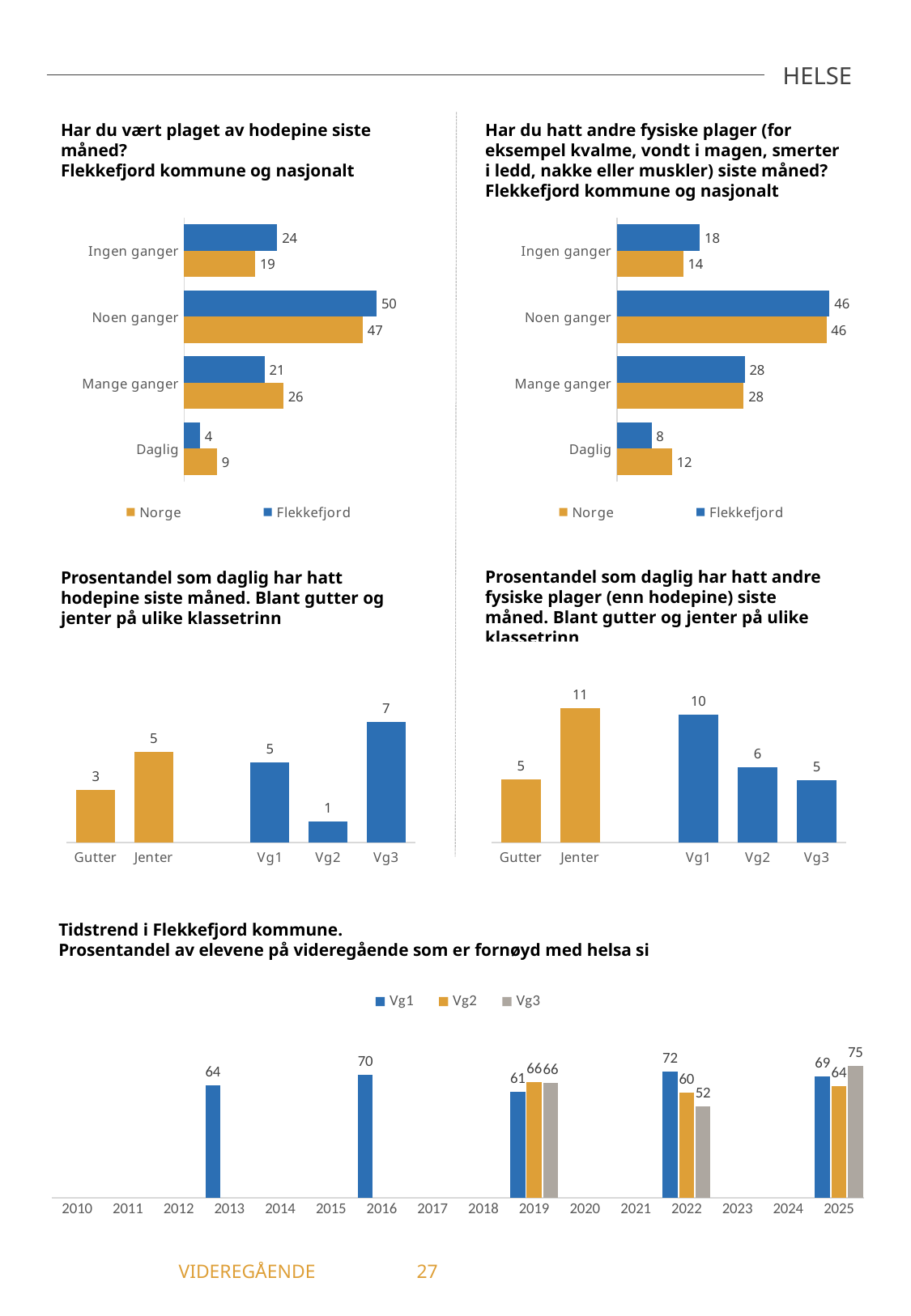
In the chart 'Prosentandel som daglig har hatt andre fysiske plager (enn hodepine) siste måned', which is larger, the value for Gutter or for Jenter? Jenter In the chart 'Tidstrend i Flekkefjord kommune', what is the value for Vg3 in 2025? 75 In the chart 'Har du vært plaget av hodepine siste måned?', which category has the lowest value for Flekkefjord? Daglig In the chart 'Har du vært plaget av hodepine siste måned?', what is the difference between the Norge and Flekkefjord values for 'Daglig'? 5 In the chart 'Prosentandel som daglig har hatt andre fysiske plager (enn hodepine) siste måned', what is the difference between Vg1 and Vg3? 5 In the chart 'Prosentandel som daglig har hatt hodepine siste måned', which category has the highest value? Vg3 How many series does the legend list in the chart 'Har du hatt andre fysiske plager ... siste måned?'? 2 In the chart 'Har du vært plaget av hodepine siste måned?', what is the value for Flekkefjord in the 'Noen ganger' category? 50 What kind of chart is 'Tidstrend i Flekkefjord kommune'? Bar chart In the chart 'Prosentandel som daglig har hatt hodepine siste måned', what is the value for Vg2? 1 In the chart 'Har du hatt andre fysiske plager ... siste måned?', what is the value for Norge in the 'Ingen ganger' category? 14 In the chart 'Har du hatt andre fysiske plager ... siste måned?', which category has the highest value for Norge? Noen ganger